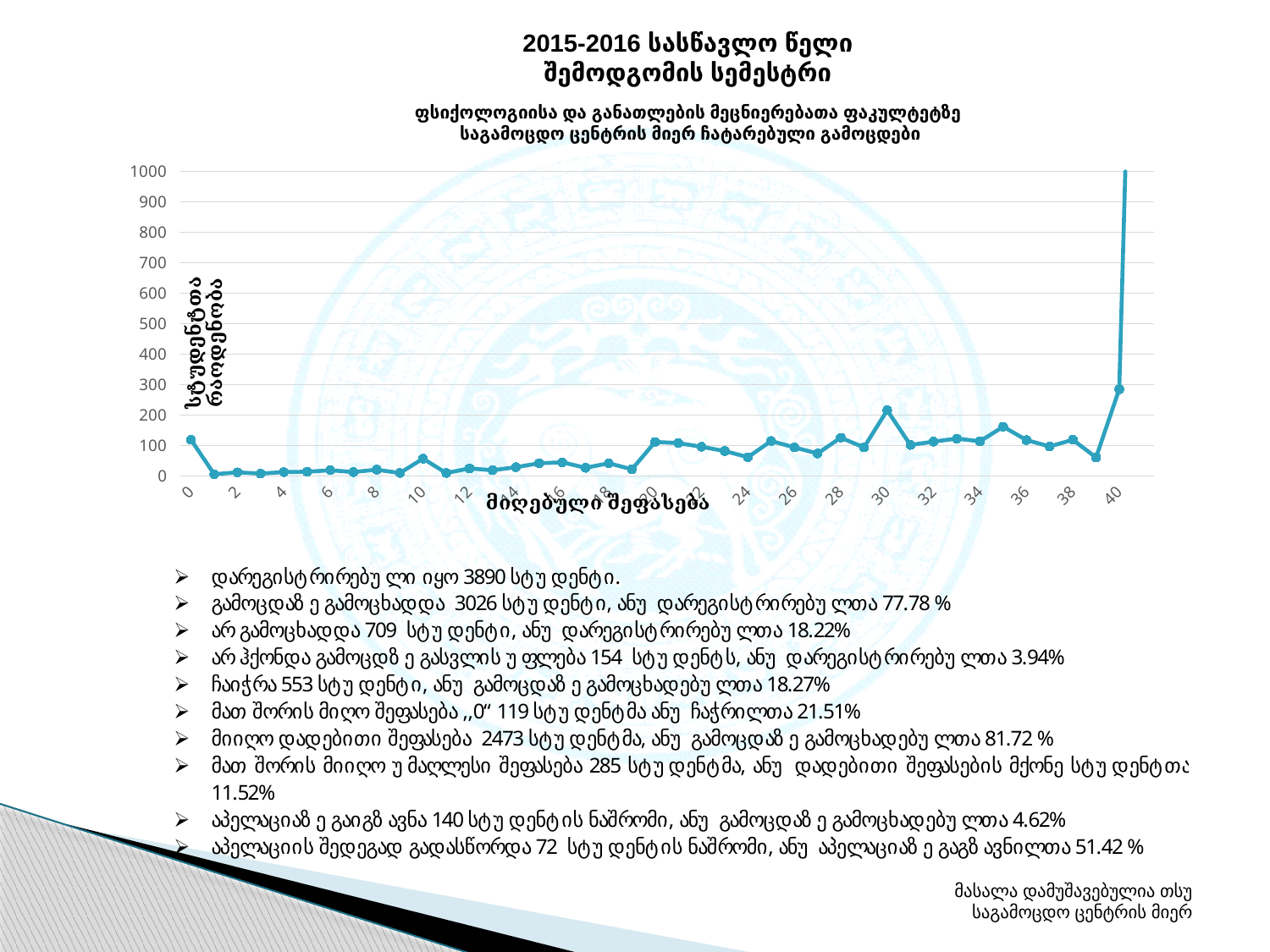
How many data points are plotted on the line (scores 0 through 40)? 42 What kind of chart is shown on the slide? line chart Is the number of students with score 30 greater or less than 100? greater Is the number of students with score 1 greater or less than 100? less What is the title of the y axis? სტუდენტთა რაოდენობა Which score has more students, 0 or 10? 0 Which score has more students, 30 or 20? 30 Is the number of students with score 39 greater or less than 100? less Which score on the x axis has the highest number of students? 40 What is the title of the x axis? მიღებული შეფასება